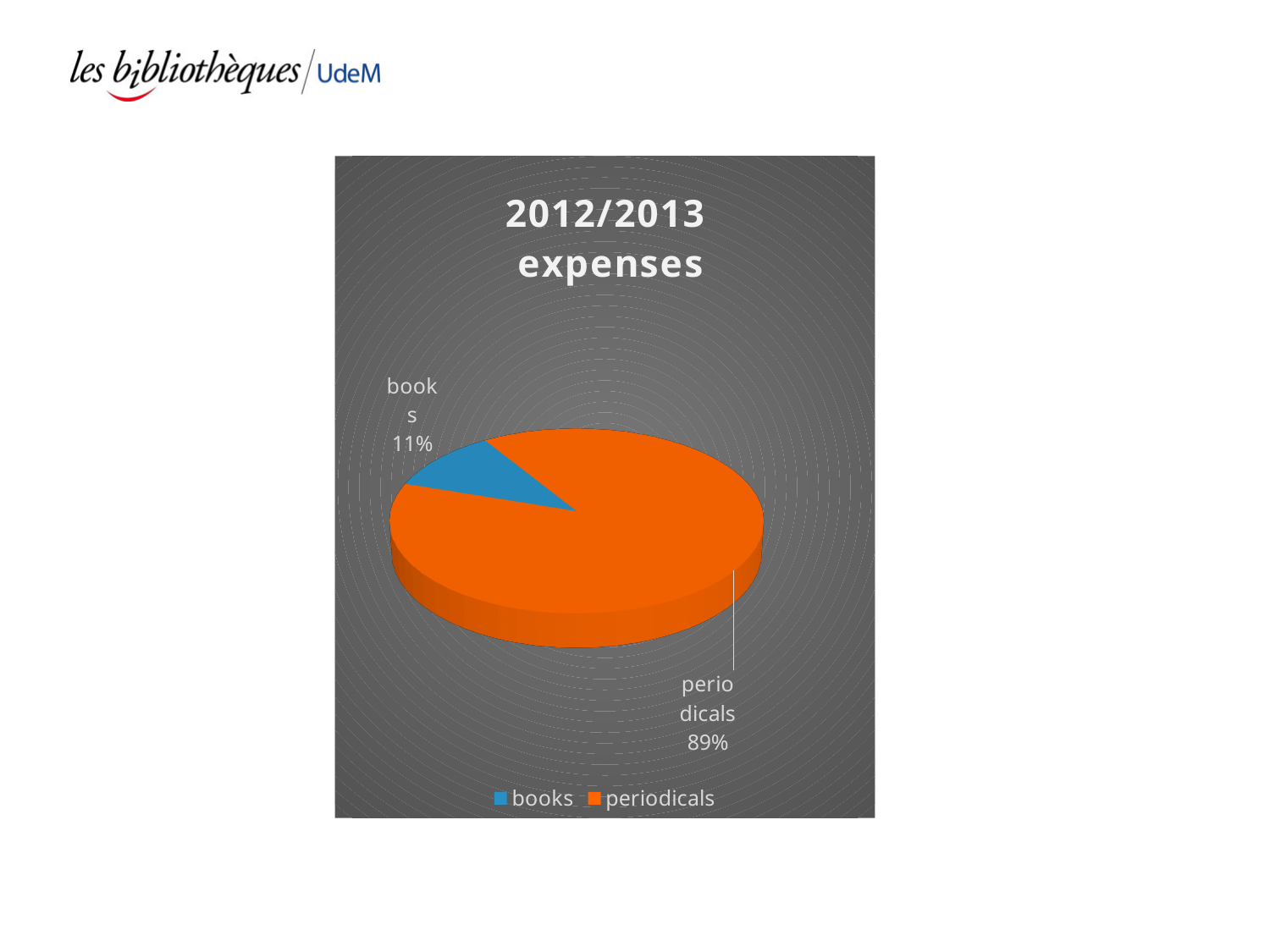
Which category has the largest share in the 2012/2013 expenses chart? periodicals What is the title of the chart? 2012/2013 expenses What share of the 2012/2013 expenses pie chart is periodicals? 89% What is the difference in percentage points between the periodicals and books shares? 78 How many categories are shown in the 2012/2013 expenses pie chart? 2 Which category has the smallest share in the 2012/2013 expenses chart? books What colour is the periodicals slice in the pie chart? orange How many entries does the legend of the chart list? 2 What kind of chart is shown on the slide? pie chart Which is larger in the 2012/2013 expenses chart, books or periodicals? periodicals What share of the 2012/2013 expenses pie chart is books? 11%